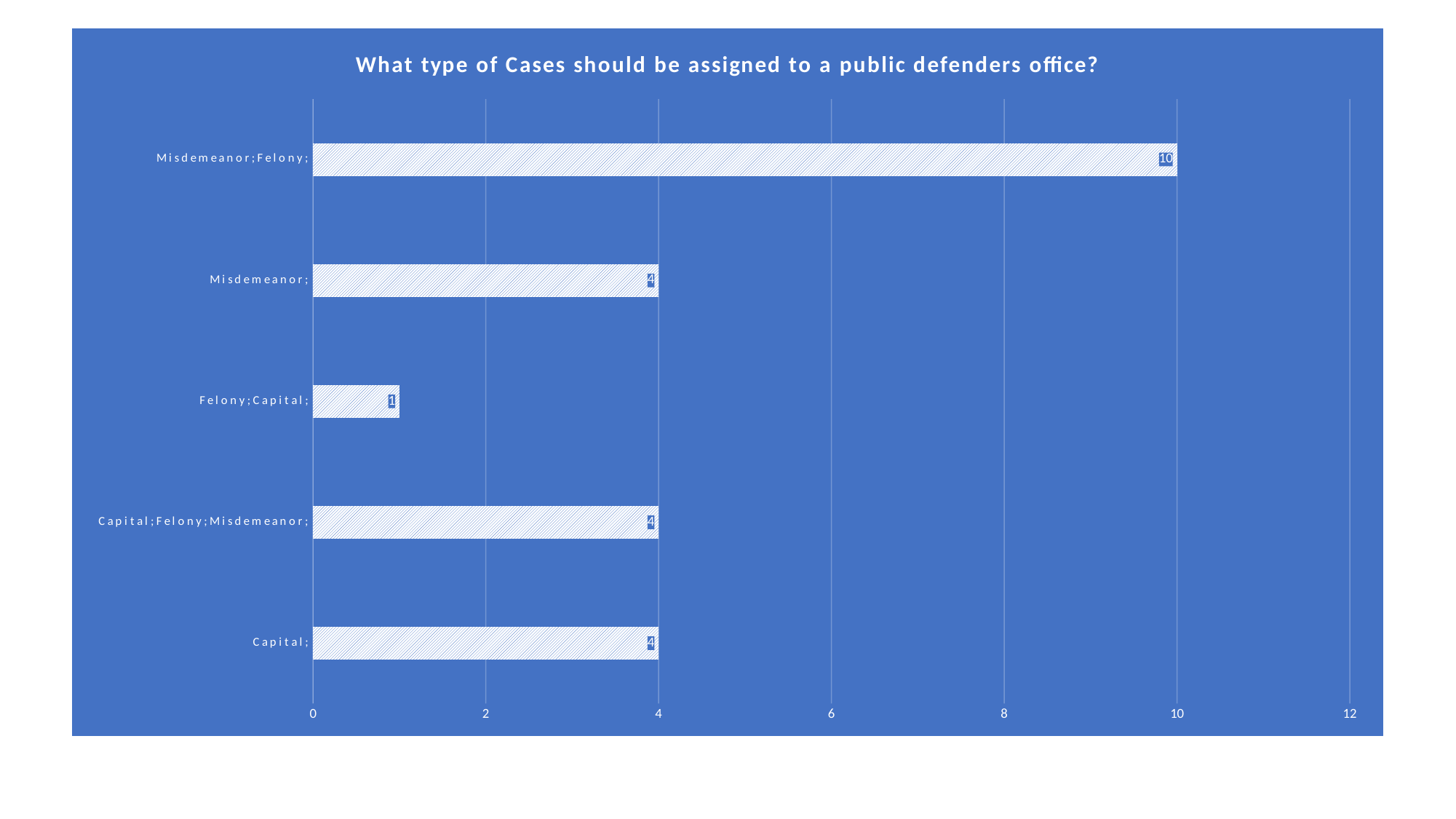
Which is larger, the value for Misdemeanor; or the value for Felony;Capital;? Misdemeanor; What kind of chart is shown on the slide? bar chart What is the value for Capital;? 4 What is the value for Misdemeanor;Felony;? 10 How many categories are shown in the chart? 5 Which category has the highest value? Misdemeanor;Felony; What is the difference between the values for Misdemeanor;Felony; and Misdemeanor;? 6 Which category has the lowest value? Felony;Capital; What is the title of the chart? What type of Cases should be assigned to a public defenders office? What is the value for Capital;Felony;Misdemeanor;? 4 Is the value for Misdemeanor;Felony; greater or less than 8? greater What is the value for Felony;Capital;? 1